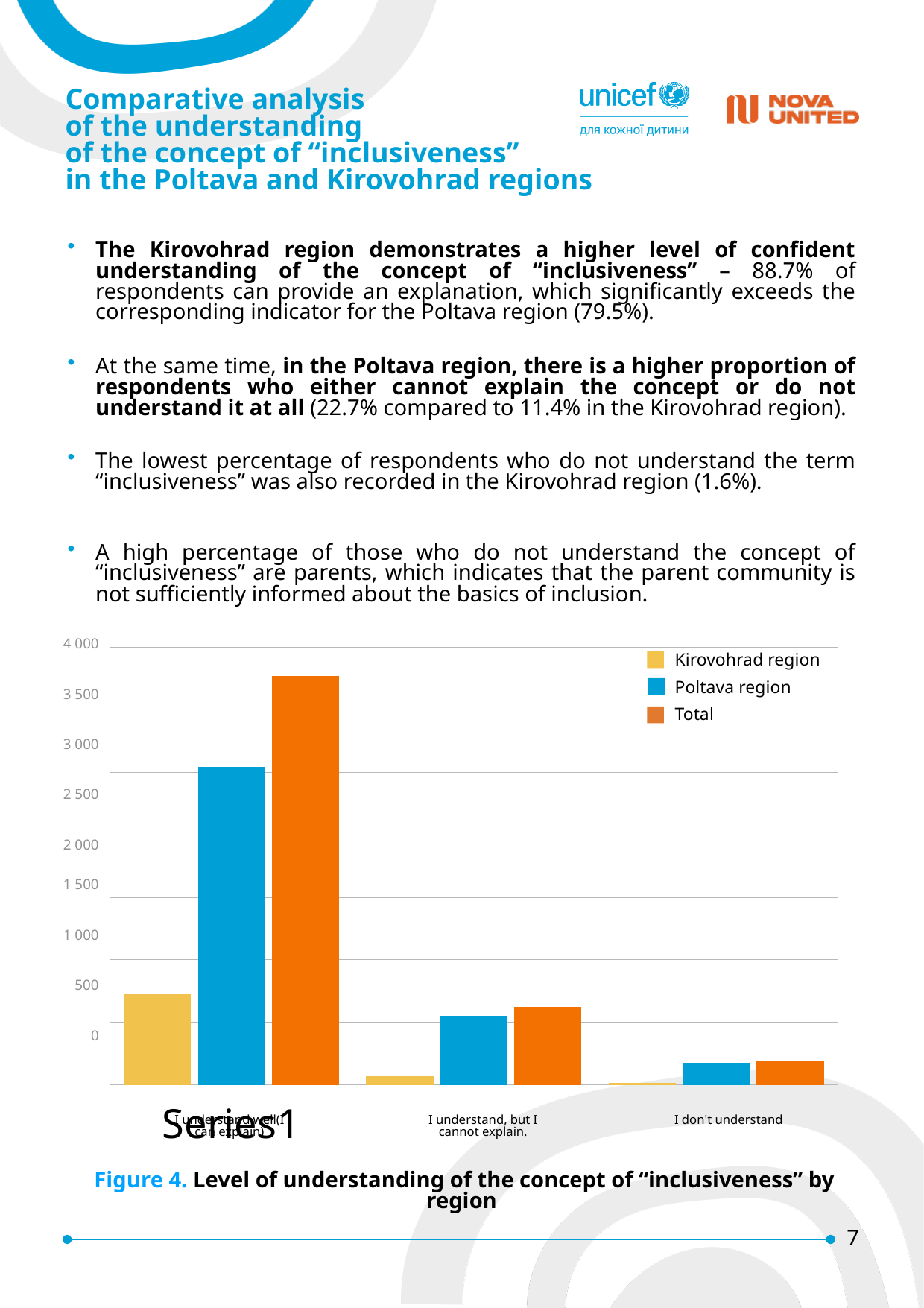
Is the Poltava region value for "I understand well (I can explain)" greater or less than 2000? greater Do the Total series values rise or fall moving from left to right across the categories? fall How many series does the chart legend list? 3 Which category has the highest value for the Total series? I understand well (I can explain) How many categories are shown along the x axis of the chart? 3 Which category has the lowest value for the Poltava region series? I don't understand Is the Total value for "I don't understand" greater or less than 500? less What kind of chart is shown on the slide? bar chart Which colour represents the Total series in the chart legend? orange In the "I understand, but I cannot explain." category, which is larger: the Total bar or the Kirovohrad region bar? Total Is the Total value for "I understand well (I can explain)" greater or less than 3000? greater In the "I understand well (I can explain)" category, which is larger: the Poltava region bar or the Kirovohrad region bar? Poltava region